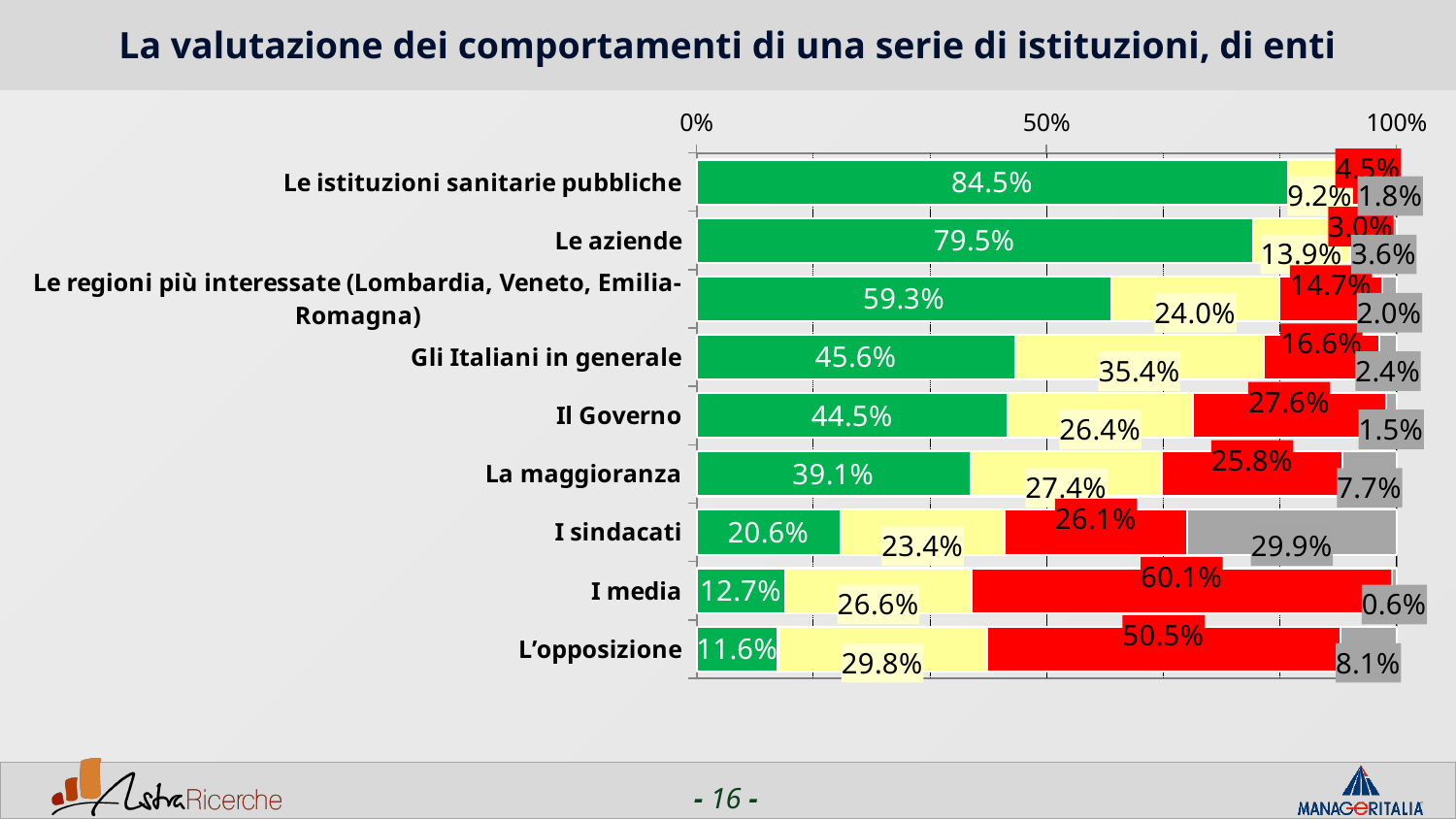
Which is larger: the yellow segment for "Gli Italiani in generale" or the yellow segment for "Il Governo"? Gli Italiani in generale What type of chart is shown on the slide? Stacked bar chart Is the green segment for "Le regioni più interessate (Lombardia, Veneto, Emilia-Romagna)" greater or less than 50%? greater What is the value of the red segment for "I media"? 60.1% What is the value of the grey segment for "I sindacati"? 29.9% What is the difference between the green segment for "Le aziende" and the green segment for "Il Governo"? 35.0 percentage points What is the value of the green segment for "Il Governo"? 44.5% Which category has the smallest green segment? L'opposizione Which category has the largest red segment? I media What is the value of the yellow segment for "L'opposizione"? 29.8% Which category has the largest green segment? Le istituzioni sanitarie pubbliche How many categories are shown in the chart? 9